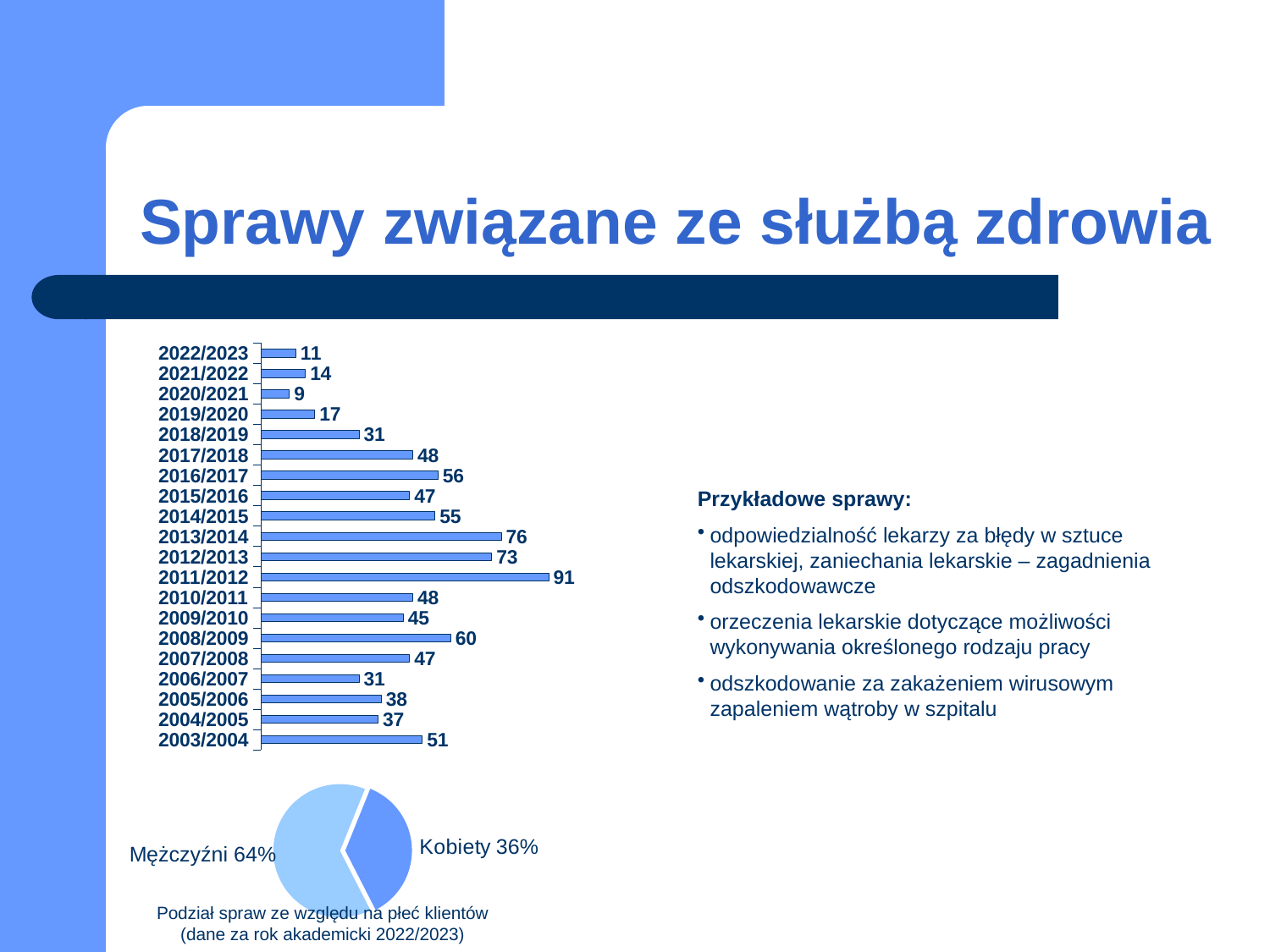
In the bar chart, what is the value for 2011/2012? 91 In the bar chart, what is the value for 2022/2023? 11 In the pie chart at the bottom left, what share is labelled Mężczyźni? 64% What kind of chart is the chart at the bottom left of the slide? pie chart In the bar chart, what is the value for 2008/2009? 60 How many academic years are shown in the bar chart? 20 In the bar chart, which academic year has the lowest value? 2020/2021 In the bar chart, which is larger, the value for 2016/2017 or the value for 2014/2015? 2016/2017 In the pie chart at the bottom left, what share is labelled Kobiety? 36% In the bar chart, what is the difference between the values for 2013/2014 and 2012/2013? 3 What kind of chart is the chart at the top left of the slide? bar chart In the bar chart, which academic year has the highest value? 2011/2012